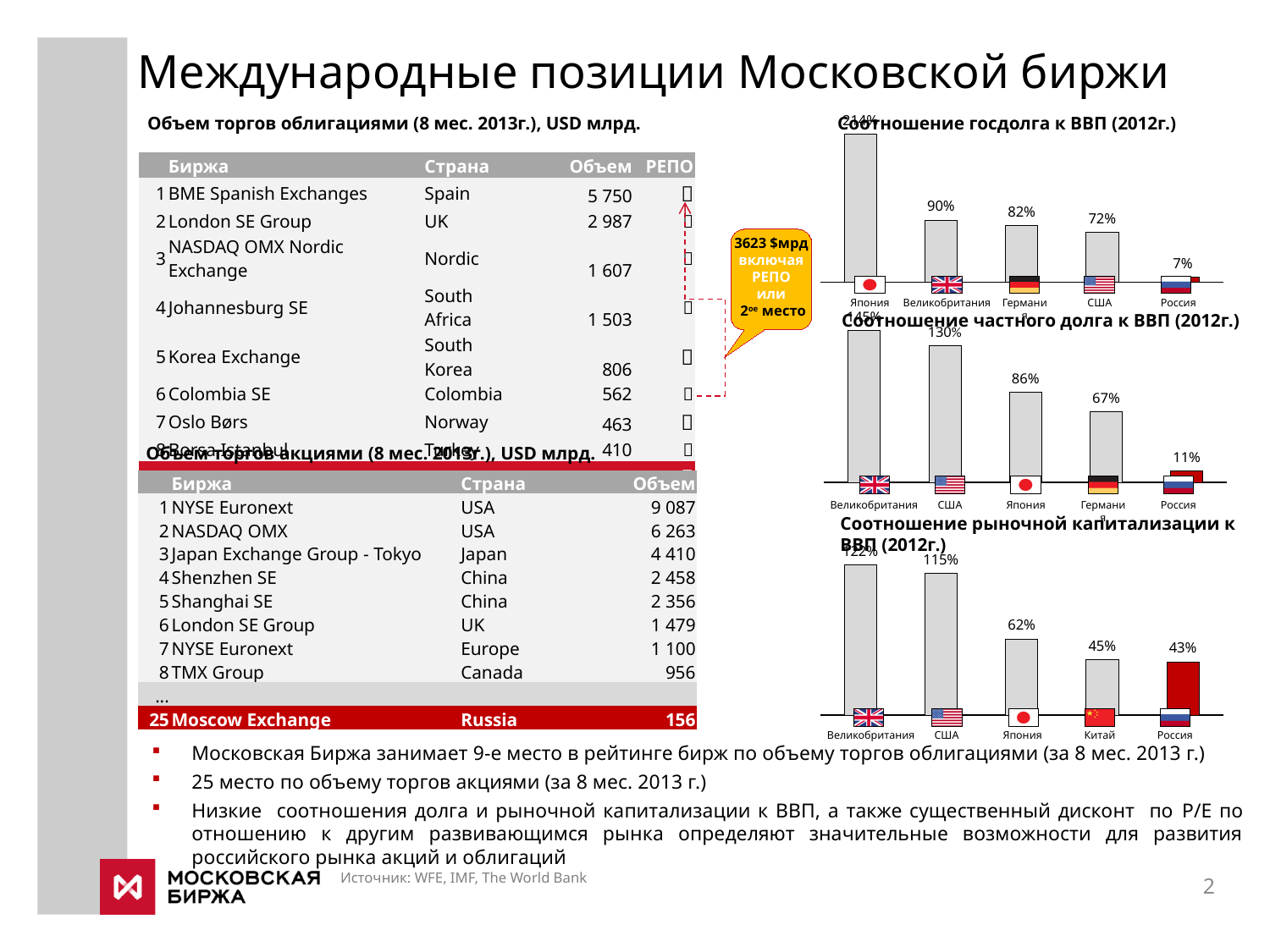
In the chart 'Соотношение госдолга к ВВП (2012г.)', what is the value for Великобритания? 90% In the chart 'Соотношение частного долга к ВВП (2012г.)', what is the value for США? 130% In the chart 'Соотношение частного долга к ВВП (2012г.)', how many countries are shown? 5 In the chart 'Соотношение рыночной капитализации к ВВП (2012г.)', what is the value for Китай? 45% In the chart 'Соотношение госдолга к ВВП (2012г.)', what is the difference between the values for Германия and США? 10% What type of chart is 'Соотношение рыночной капитализации к ВВП (2012г.)'? Bar chart In the chart 'Соотношение частного долга к ВВП (2012г.)', which is larger, the value for Германия or the value for Россия? Германия In the chart 'Соотношение рыночной капитализации к ВВП (2012г.)', what is the value for США? 115% In the chart 'Соотношение госдолга к ВВП (2012г.)', which country has the lowest value? Россия In the chart 'Соотношение рыночной капитализации к ВВП (2012г.)', what is the difference between the values for Япония and Россия? 19% In the chart 'Соотношение госдолга к ВВП (2012г.)', what is the value for Россия? 7% In the chart 'Соотношение частного долга к ВВП (2012г.)', what is the value for Япония? 86%